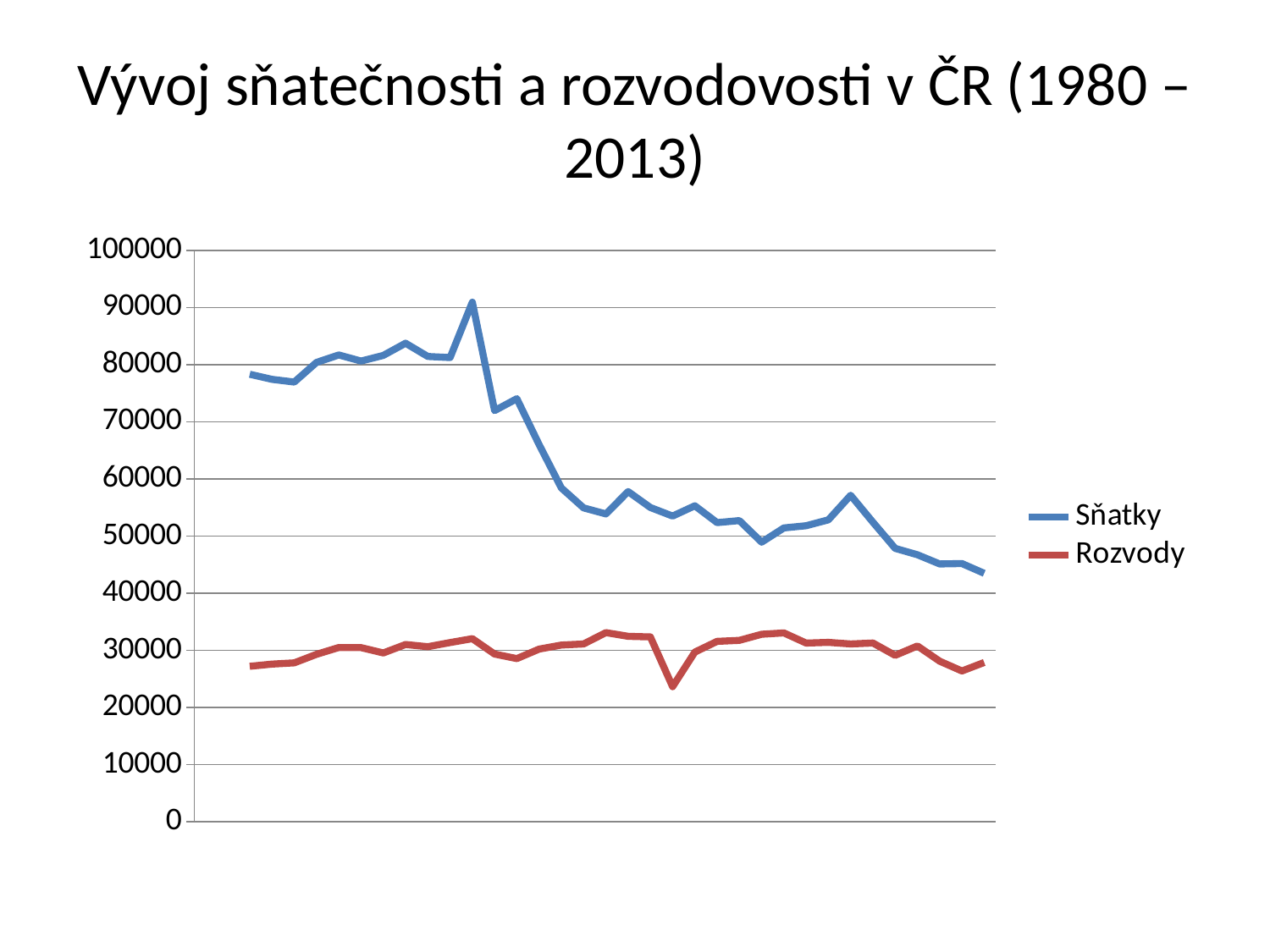
Is the last point of the Sňatky series greater or less than 50000? less What kind of chart is shown on the slide? line chart Is the highest point of the Rozvody series greater or less than 40000? less Is the highest point of the Sňatky series greater or less than 80000? greater Does the Sňatky series overall rise or fall from left to right? fall How many series does the legend list? 2 What is the title of the slide? Vývoj sňatečnosti a rozvodovosti v ČR (1980 – 2013) Which series has higher values throughout the chart, Sňatky or Rozvody? Sňatky What are the two series named in the legend? Sňatky and Rozvody Which series contains the lowest point plotted on the chart? Rozvody